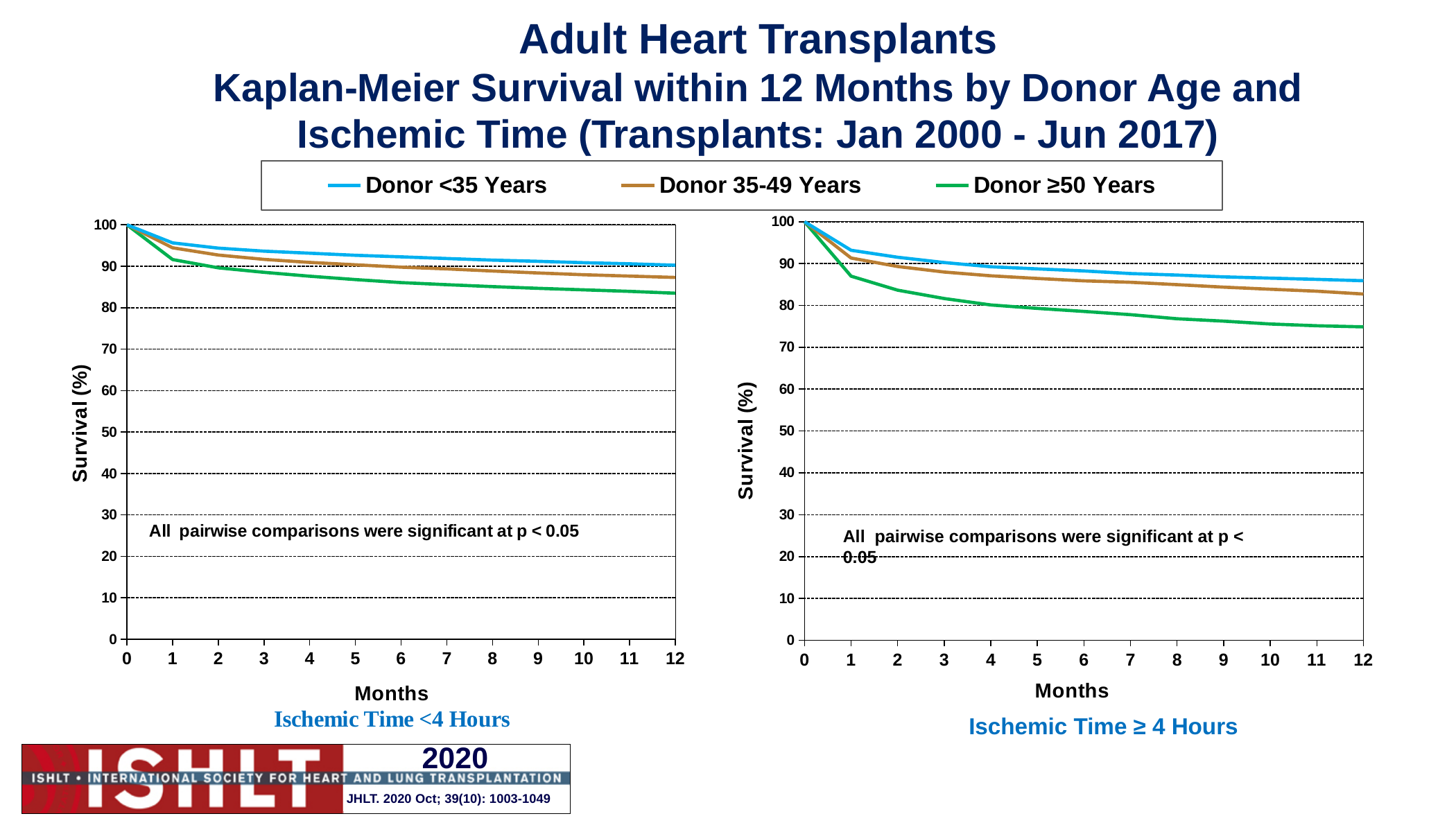
In the 'Ischemic Time ≥ 4 Hours' chart, which donor age group has the lowest survival at 12 months? Donor ≥50 Years What is the label of the y axis on both charts? Survival (%) In the 'Ischemic Time <4 Hours' chart, which donor age group has the highest survival at 12 months? Donor <35 Years In the 'Ischemic Time <4 Hours' chart, is the survival for Donor 35-49 Years at 12 months greater or less than 90? less In the 'Ischemic Time ≥ 4 Hours' chart, what is the survival for Donor <35 Years at 0 months? 100 What kind of chart is the 'Ischemic Time <4 Hours' chart on the left? Line chart How many series does the legend list? 3 In the 'Ischemic Time ≥ 4 Hours' chart, is the survival for Donor <35 Years at 12 months greater or less than 90? less In the 'Ischemic Time ≥ 4 Hours' chart, which is higher at 12 months: Donor <35 Years or Donor ≥50 Years? Donor <35 Years In the 'Ischemic Time <4 Hours' chart, do the survival curves rise or fall as months increase? Fall In the 'Ischemic Time ≥ 4 Hours' chart, is the survival for Donor ≥50 Years at 12 months greater or less than 80? less